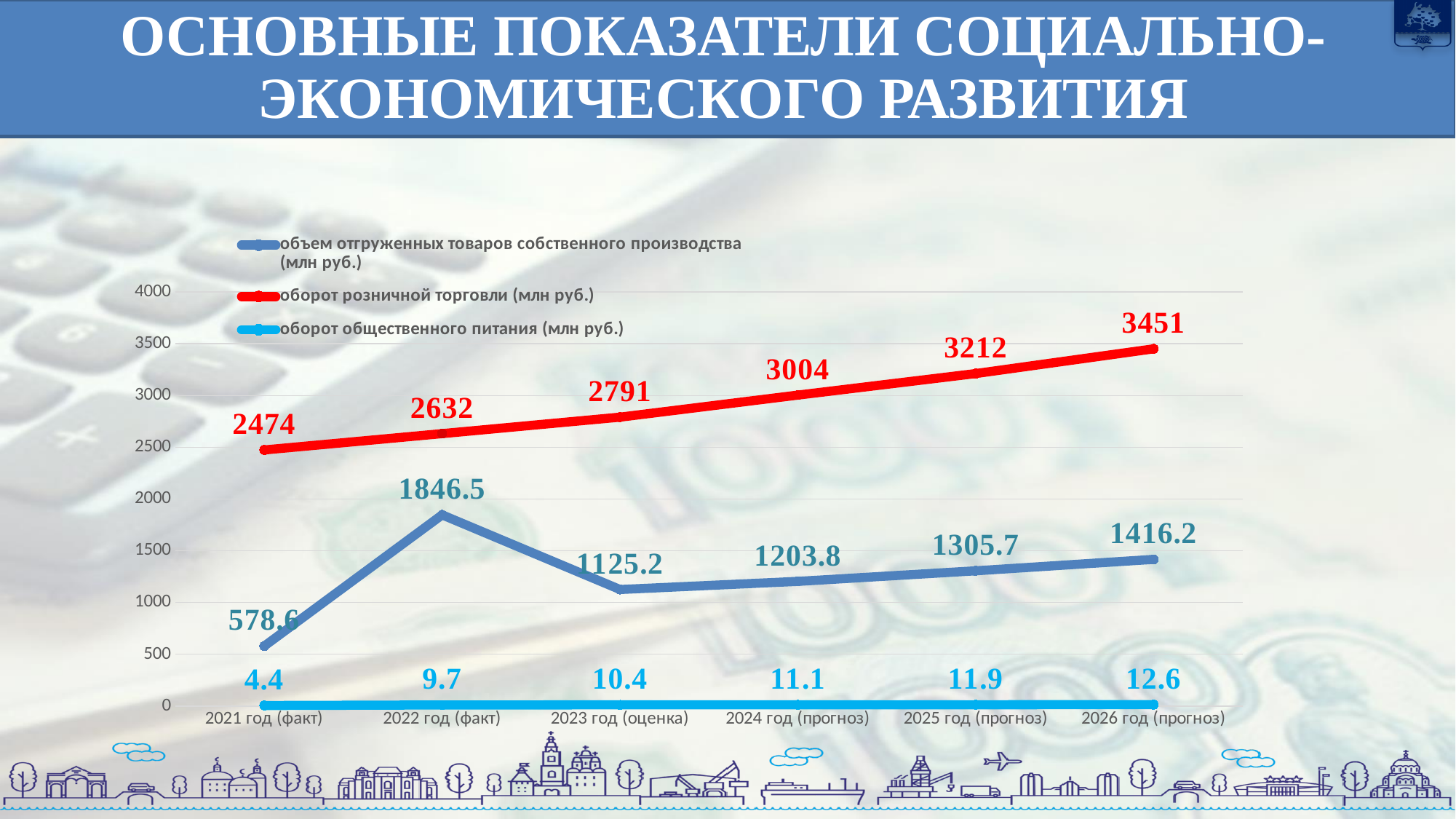
How many years (categories) are shown on the x axis? 6 In which year is оборот розничной торговли lowest? 2021 год (факт) What type of chart is shown on the slide? line chart What is the value of оборот общественного питания for 2021 год (факт)? 4.4 What is the value of объем отгруженных товаров собственного производства for 2022 год (факт)? 1846.5 How many series does the legend list? 3 What is the value of оборот розничной торговли for 2024 год (прогноз)? 3004 What is the difference between оборот розничной торговли in 2026 год (прогноз) and 2021 год (факт)? 977 Does оборот розничной торговли rise or fall from 2021 to 2026? rise What colour is the line for оборот розничной торговли? red In which year is объем отгруженных товаров собственного производства highest? 2022 год (факт) Which is larger: объем отгруженных товаров собственного производства in 2023 год (оценка) or in 2025 год (прогноз)? 2025 год (прогноз)